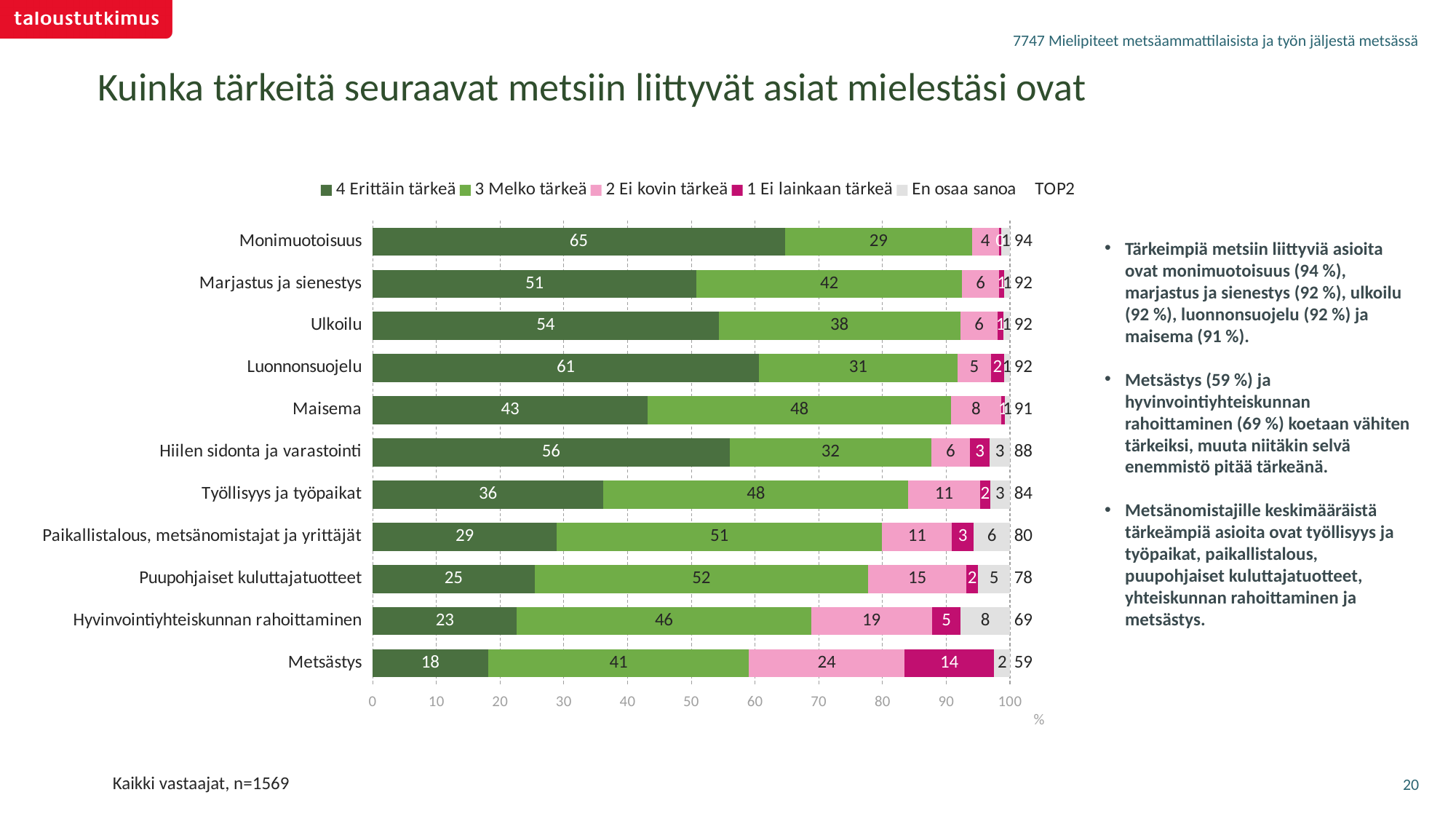
How many categories are shown on the chart? 11 How many series does the legend list with colour swatches? 5 Which has a larger '2 Ei kovin tärkeä' value, Metsästys or Hyvinvointiyhteiskunnan rahoittaminen? Metsästys What is the '3 Melko tärkeä' value for Puupohjaiset kuluttajatuotteet? 52 What kind of chart is shown on the slide? Stacked bar chart What percentage of respondents rated Monimuotoisuus as '4 Erittäin tärkeä'? 65 Which category has the lowest TOP2 value? Metsästys What is the difference between the '4 Erittäin tärkeä' values for Luonnonsuojelu and Maisema? 18 What is the combined total of the '4 Erittäin tärkeä' and '3 Melko tärkeä' segments for Työllisyys ja työpaikat? 84 What is the '1 Ei lainkaan tärkeä' value for Metsästys? 14 Which category has the highest '4 Erittäin tärkeä' value? Monimuotoisuus What is the TOP2 value shown for Hyvinvointiyhteiskunnan rahoittaminen? 69